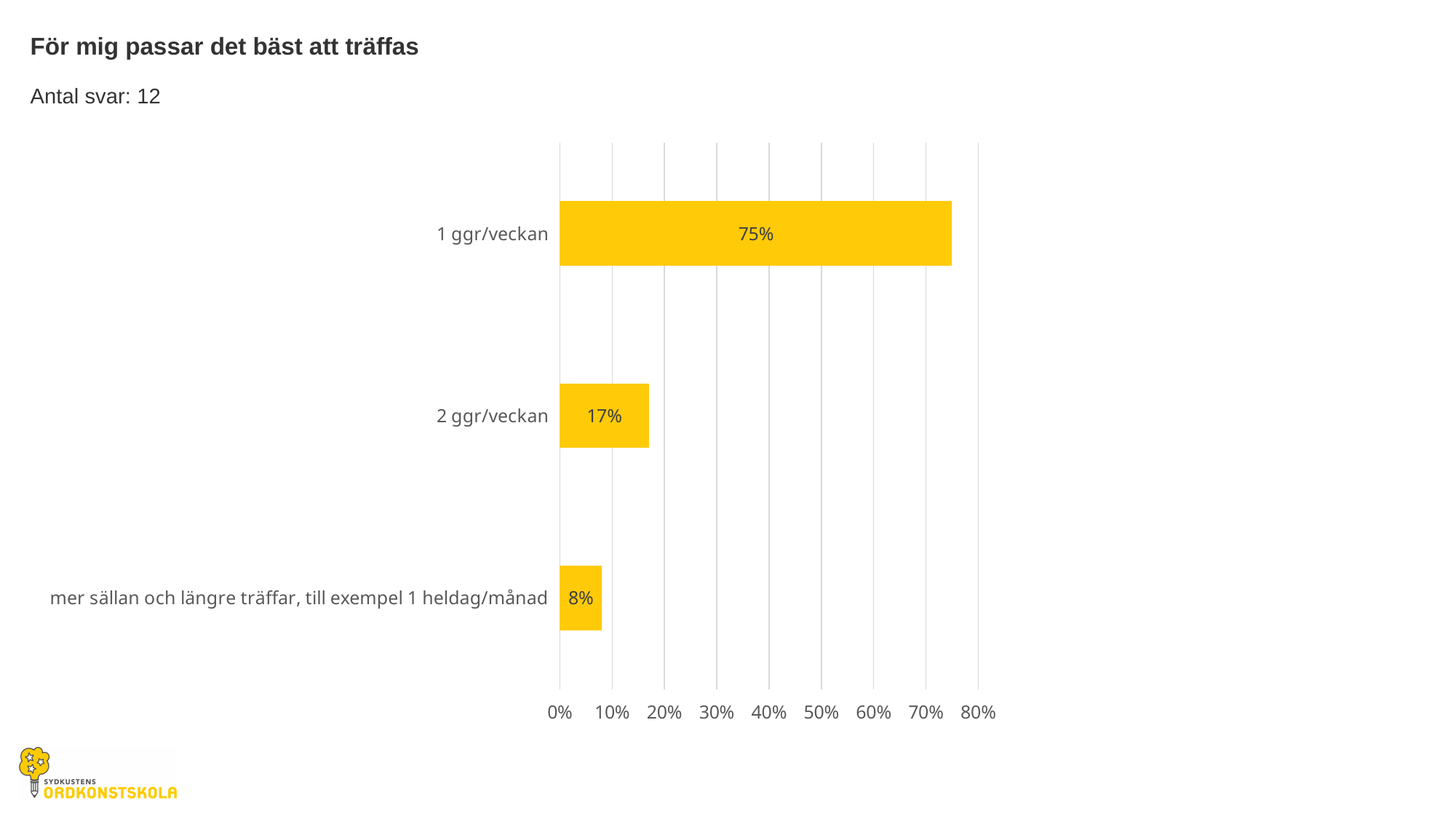
What is the value for "1 ggr/veckan"? 75% Which category has the lowest value? mer sällan och längre träffar, till exempel 1 heldag/månad What kind of chart is shown on the slide? bar chart What is the title of the chart? För mig passar det bäst att träffas What is the difference between the values for "1 ggr/veckan" and "2 ggr/veckan"? 58% Is the value for "1 ggr/veckan" greater or less than 70%? greater Which is larger, the value for "2 ggr/veckan" or the value for "mer sällan och längre träffar, till exempel 1 heldag/månad"? 2 ggr/veckan What is the value for "mer sällan och längre träffar, till exempel 1 heldag/månad"? 8% What is the value for "2 ggr/veckan"? 17% Which category has the highest value? 1 ggr/veckan How many categories are shown in the chart? 3 What is the difference between the values for "2 ggr/veckan" and "mer sällan och längre träffar, till exempel 1 heldag/månad"? 9%